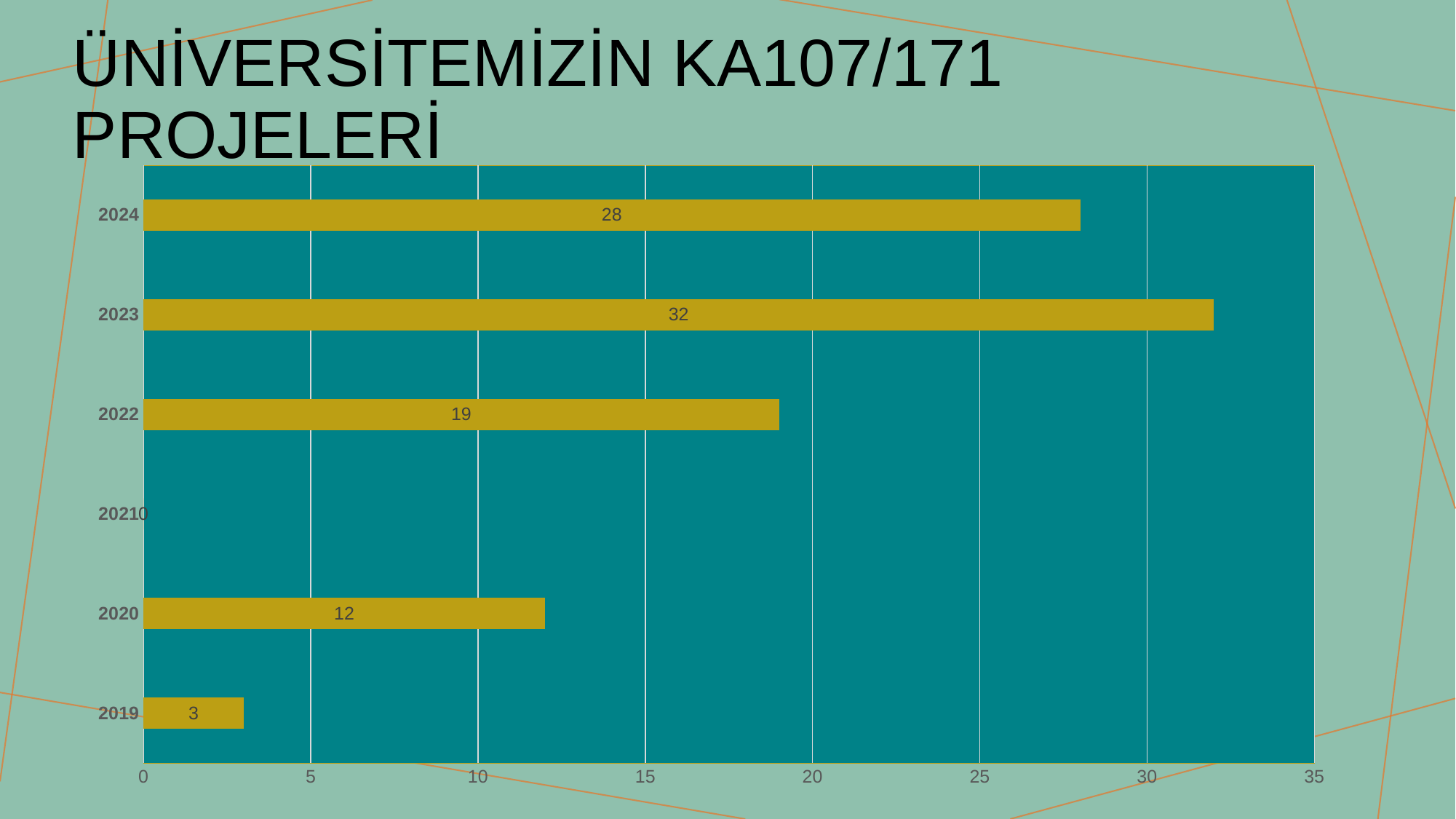
Which year has the highest value? 2023 What kind of chart is shown on the slide? bar chart What is the value for 2023? 32 How many years are shown on the chart? 6 What is the value for 2024? 28 What is the value for 2020? 12 What is the difference between the values for 2023 and 2024? 4 What is the value for 2019? 3 What is the title of the slide containing the chart? ÜNİVERSİTEMİZİN KA107/171 PROJELERİ What is the value for 2022? 19 Which year has the lowest value? 2021 Which is larger, the value for 2022 or the value for 2020? 2022